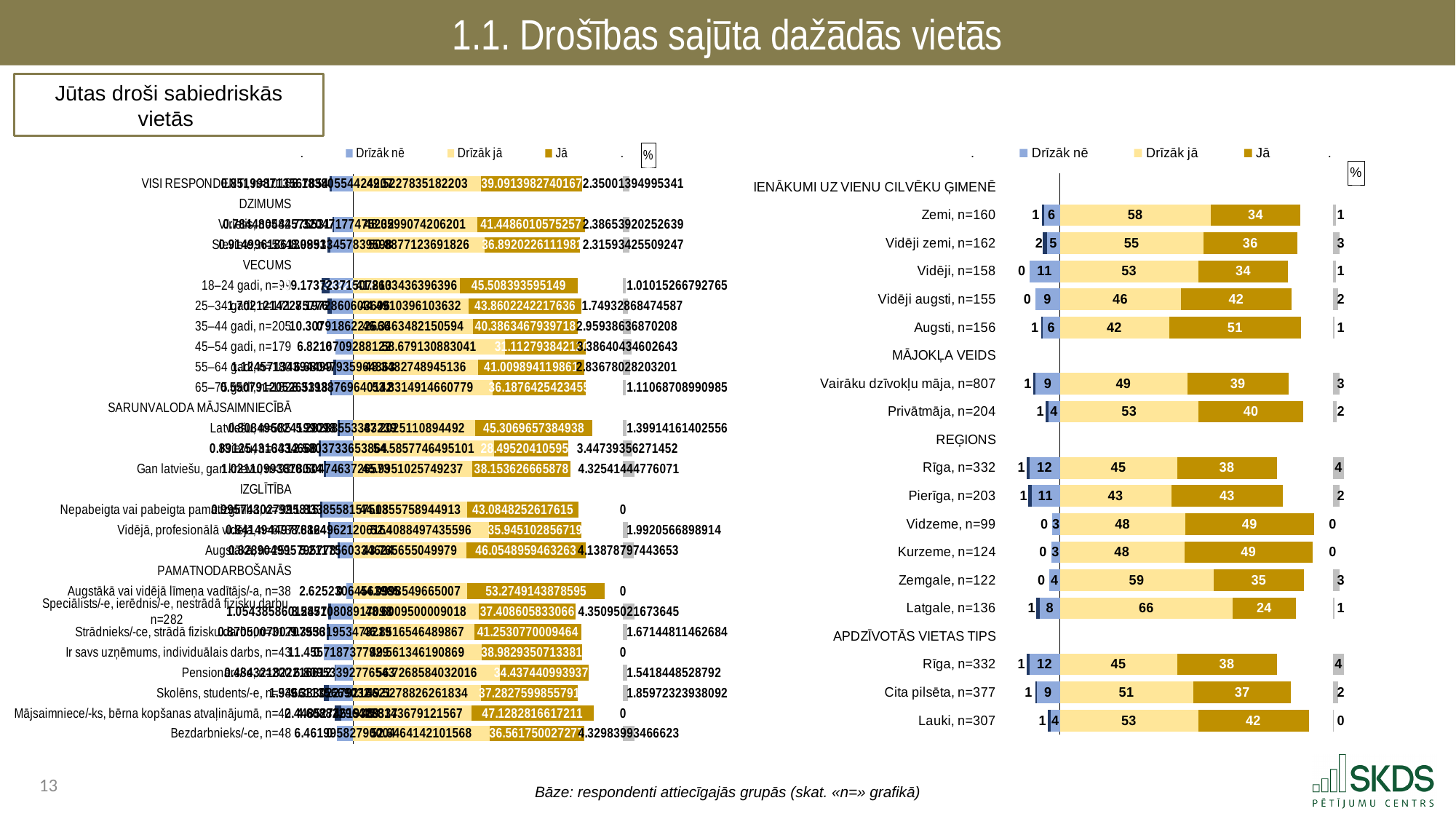
In the right-hand chart, how many income groups are listed under IENĀKUMI UZ VIENU CILVĒKU ĢIMENĒ? 5 In the right-hand chart, what is the "Drīzāk nē" value for Rīga, n=332? 12 In the right-hand chart, which income group (IENĀKUMI UZ VIENU CILVĒKU ĢIMENĒ) has the highest "Jā" value? Augsti, n=156 In the right-hand chart, what is the "Jā" value for Augsti, n=156? 51 In the right-hand chart, what is the difference between the "Drīzāk jā" values for Latgale, n=136 and Rīga, n=332? 21 In the right-hand chart, which has the larger "Drīzāk jā" value: Zemgale, n=122 or Pierīga, n=203? Zemgale, n=122 In the right-hand chart, what is the difference between the "Jā" values for Augsti, n=156 and Zemi, n=160? 17 What is the title shown in the box above the left-hand chart? Jūtas droši sabiedriskās vietās In the right-hand chart, which region (REĢIONS) has the lowest "Jā" value? Latgale, n=136 In the right-hand chart, which region (REĢIONS) has the highest "Drīzāk nē" value? Rīga, n=332 In the right-hand chart, what is the "Drīzāk jā" value for Latgale, n=136? 66 What type of chart is the right-hand chart? Stacked bar chart